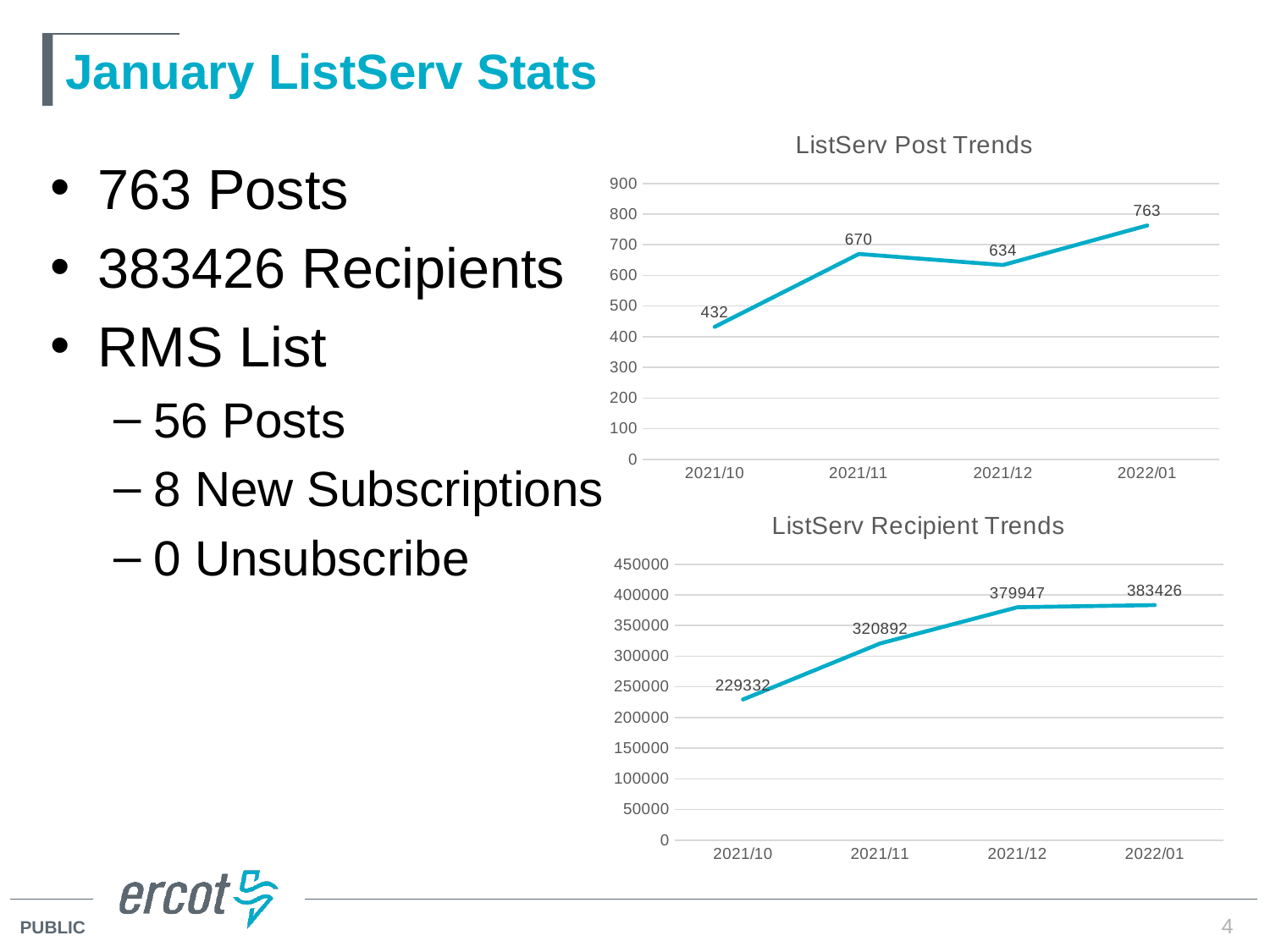
In the ListServ Post Trends chart, which month has the lowest value? 2021/10 In the ListServ Recipient Trends chart, what is the value for 2021/12? 379947 In the ListServ Recipient Trends chart, do the values rise or fall from 2021/10 to 2022/01? Rise In the ListServ Post Trends chart, what is the value for 2021/11? 670 In the ListServ Post Trends chart, what is the difference between the values for 2022/01 and 2021/12? 129 In the ListServ Post Trends chart, how many data points are plotted? 4 In the ListServ Post Trends chart, is the value for 2021/11 or 2021/12 larger? 2021/11 In the ListServ Recipient Trends chart, what is the difference between the values for 2021/11 and 2021/10? 91560 In the ListServ Post Trends chart, which month has the highest value? 2022/01 What kind of chart is the ListServ Post Trends chart? Line chart In the ListServ Recipient Trends chart, what is the value for 2021/10? 229332 What is the title of the lower chart on the slide? ListServ Recipient Trends